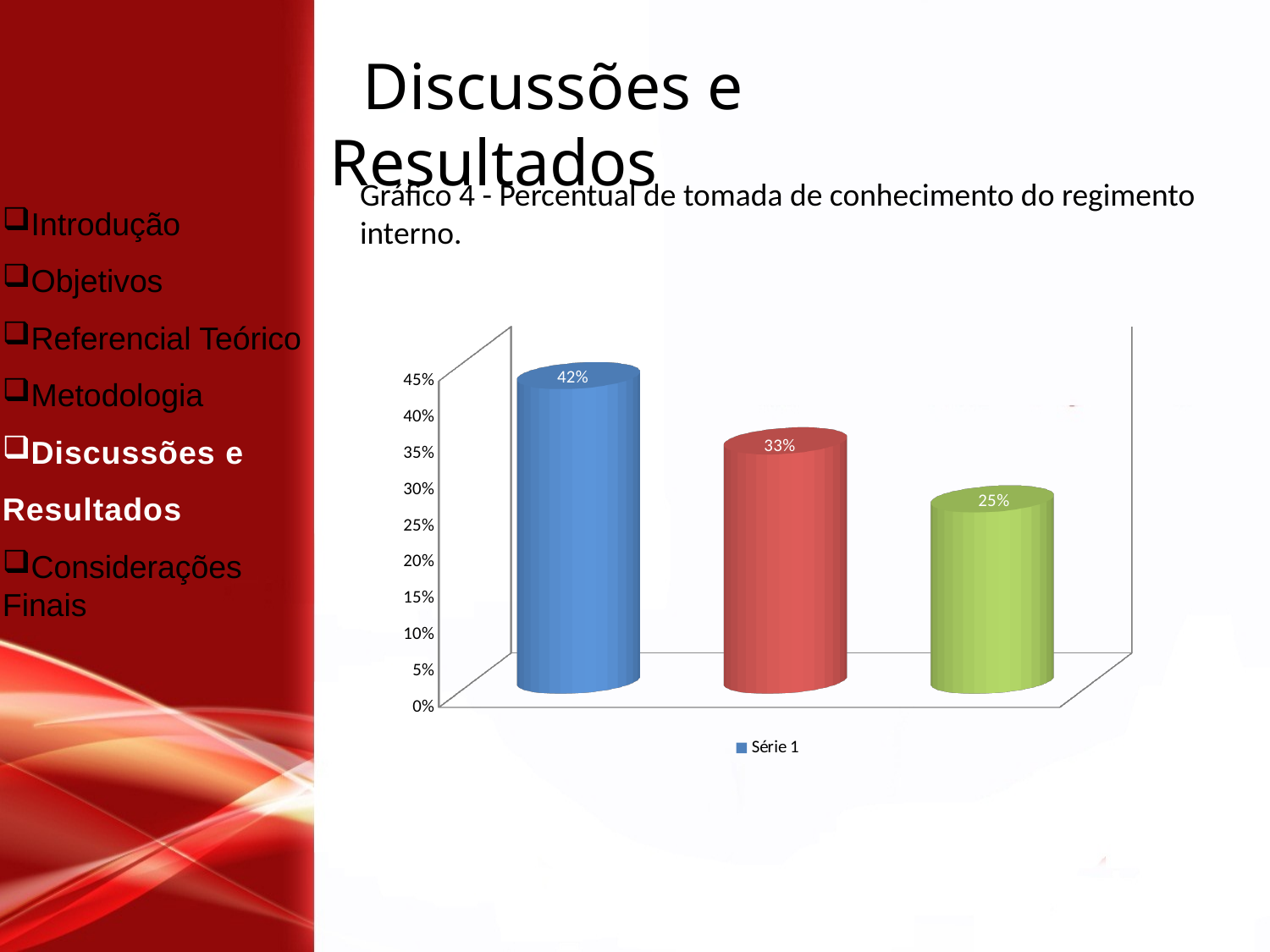
Which is larger, the value of the red bar or the value of the green bar? The red bar (33%) What value is shown on the green bar (the rightmost bar)? 25% What value is shown on the red bar (the middle bar)? 33% What is the difference between the value of the blue bar and the value of the green bar? 17% Which bar has the highest value? The blue (first) bar, 42% What value is shown on the blue bar (the first bar from the left)? 42% What is the difference between the value of the blue bar and the value of the red bar? 9% How many series does the legend list? 1 What kind of chart is shown on the slide? Bar chart How many bars are plotted in the chart? 3 Which bar has the lowest value? The green (third) bar, 25% Do the bar values rise or fall from left to right? Fall